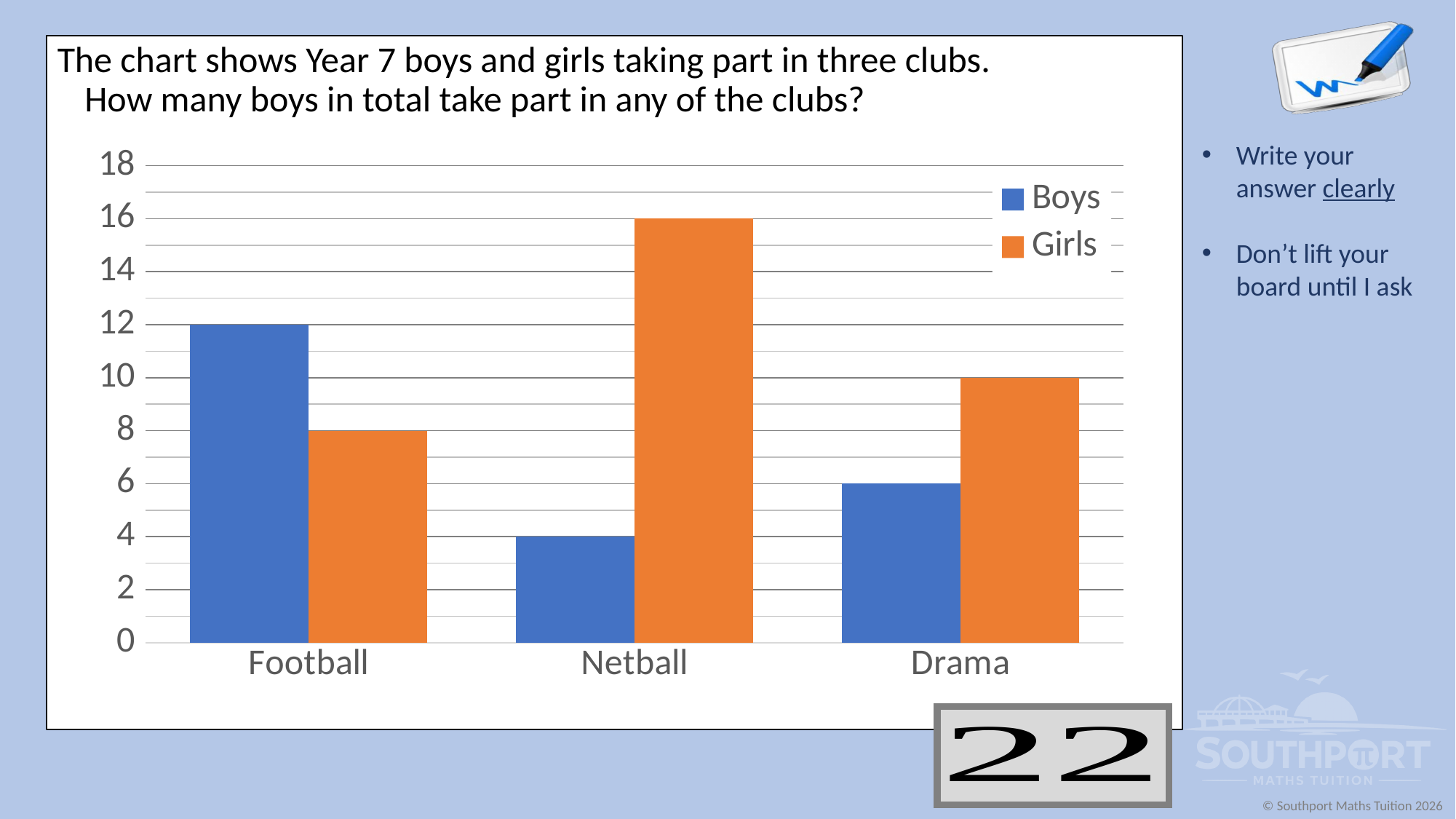
How many series does the legend list? 2 How many clubs are shown on the x axis? 3 Which is larger, the number of boys in Football or the number of girls in Football? Boys in Football How many girls take part in Netball? 16 What kind of chart is shown on the slide? bar chart How many girls take part in Football? 8 Which colour represents Girls in the legend? orange How many boys take part in Drama? 6 Which club has the highest number of girls? Netball How many boys take part in Football? 12 What is the difference between the number of girls and boys in Netball? 12 Which club has the lowest number of boys? Netball